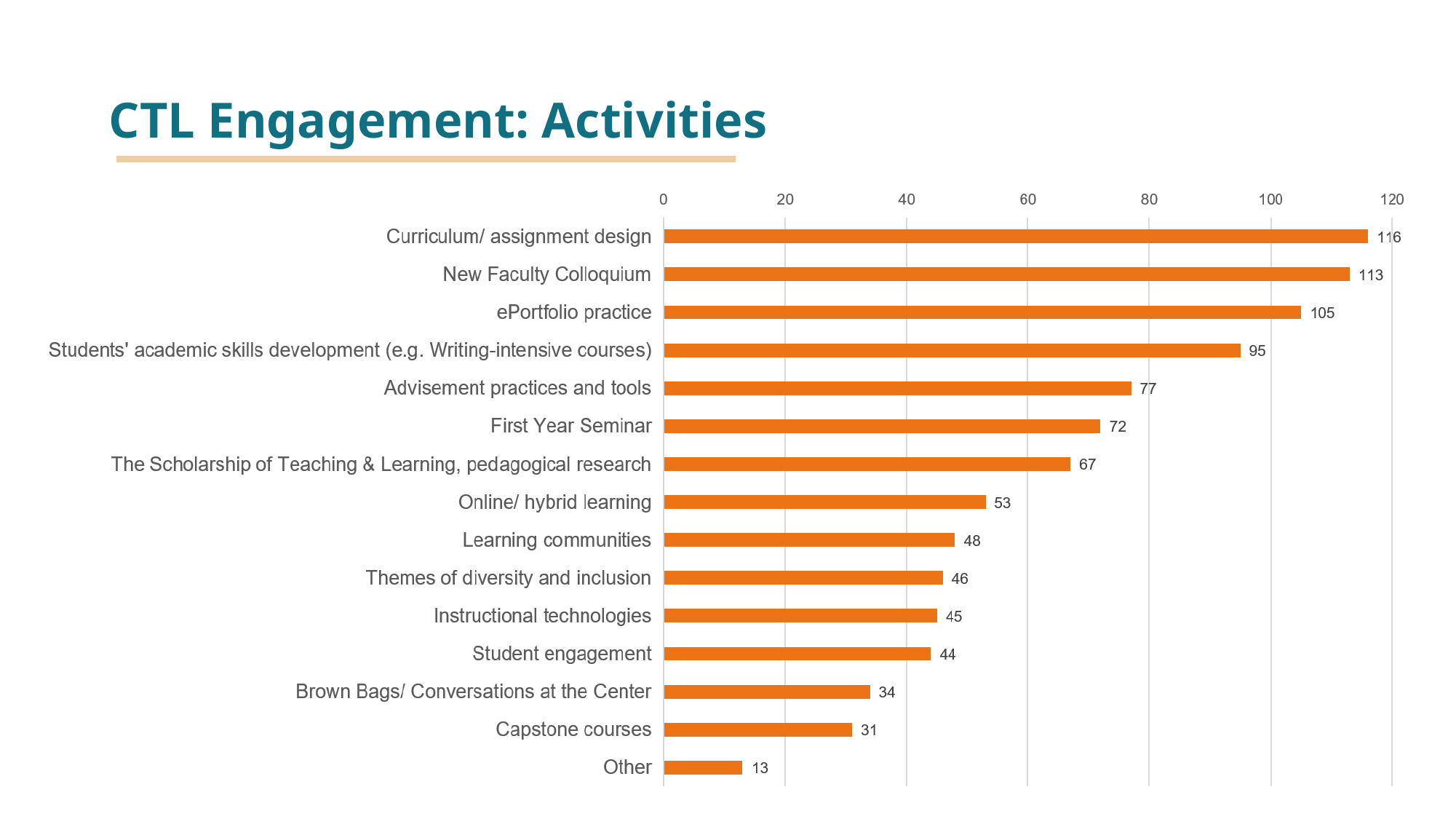
How many activities are shown in the chart? 15 What is the title of the slide? CTL Engagement: Activities What is the value for Capstone courses? 31 What is the value for Curriculum/ assignment design? 116 Which is larger, the value for Advisement practices and tools or the value for Learning communities? Advisement practices and tools Is the value for Students' academic skills development (e.g. Writing-intensive courses) greater or less than 80? greater Which activity has the lowest value? Other What is the difference between the values for New Faculty Colloquium and First Year Seminar? 41 What kind of chart is shown on the slide? bar chart What is the value for ePortfolio practice? 105 Which activity has the highest value? Curriculum/ assignment design What is the value for Online/ hybrid learning? 53